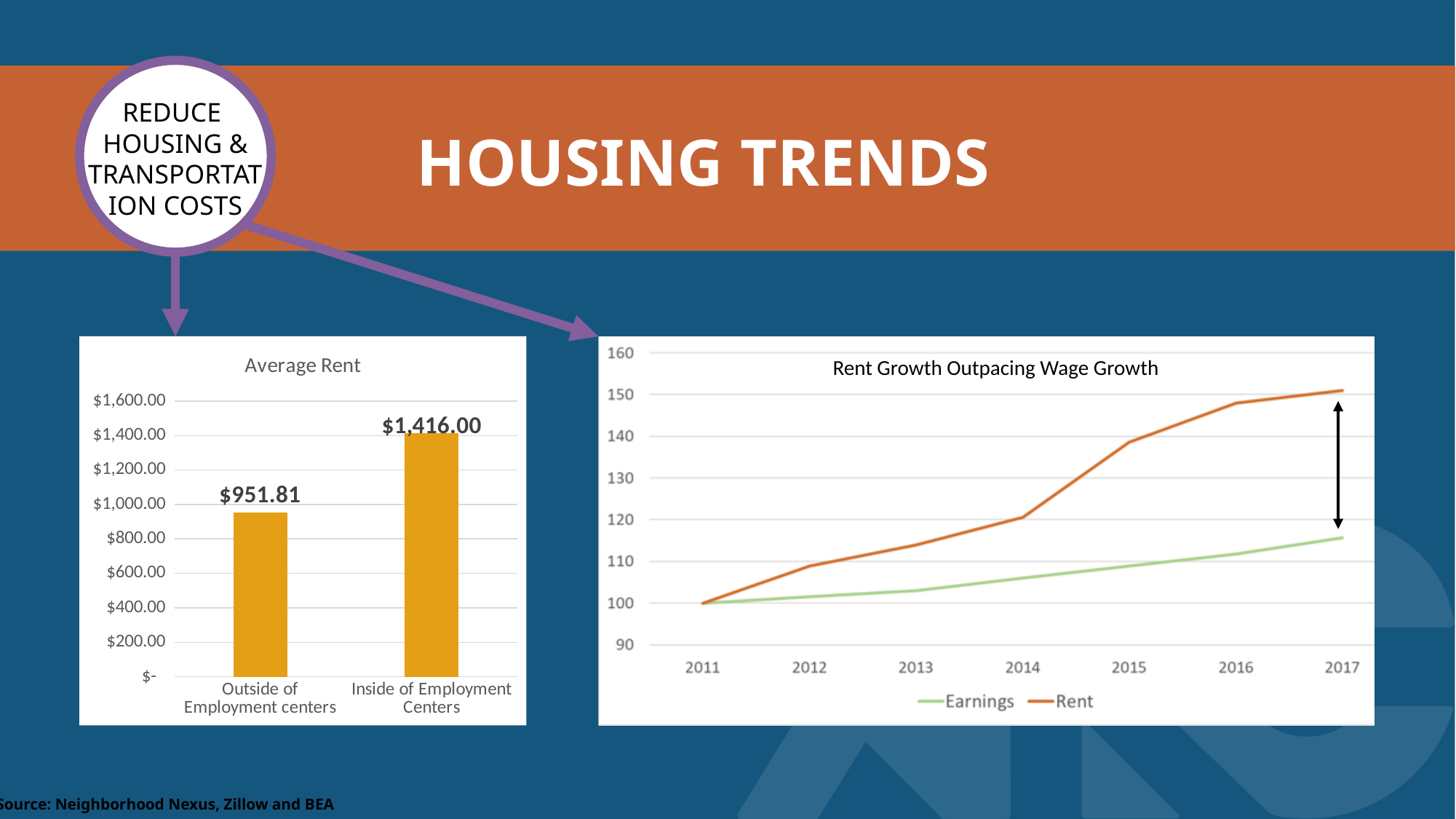
In the Rent Growth Outpacing Wage Growth chart, what kind of chart is shown? Line chart In the Rent Growth Outpacing Wage Growth chart, does the Rent series rise or fall from 2011 to 2017? Rise In the Rent Growth Outpacing Wage Growth chart, which series is higher in 2016, Earnings or Rent? Rent In the Average Rent chart, what is the average rent outside of employment centers? $951.81 In the Rent Growth Outpacing Wage Growth chart, is the Earnings value for 2017 greater or less than 120? less In the Rent Growth Outpacing Wage Growth chart, how many series does the legend list? 2 In the Average Rent chart, which category has the higher average rent? Inside of Employment Centers In the Average Rent chart, what is the average rent inside of employment centers? $1,416.00 In the Average Rent chart, how many categories are shown? 2 In the Rent Growth Outpacing Wage Growth chart, is the Rent value for 2017 greater or less than 140? greater What kind of chart is the Average Rent chart? Bar chart In the Average Rent chart, what is the difference between the average rent inside and outside of employment centers? $464.19